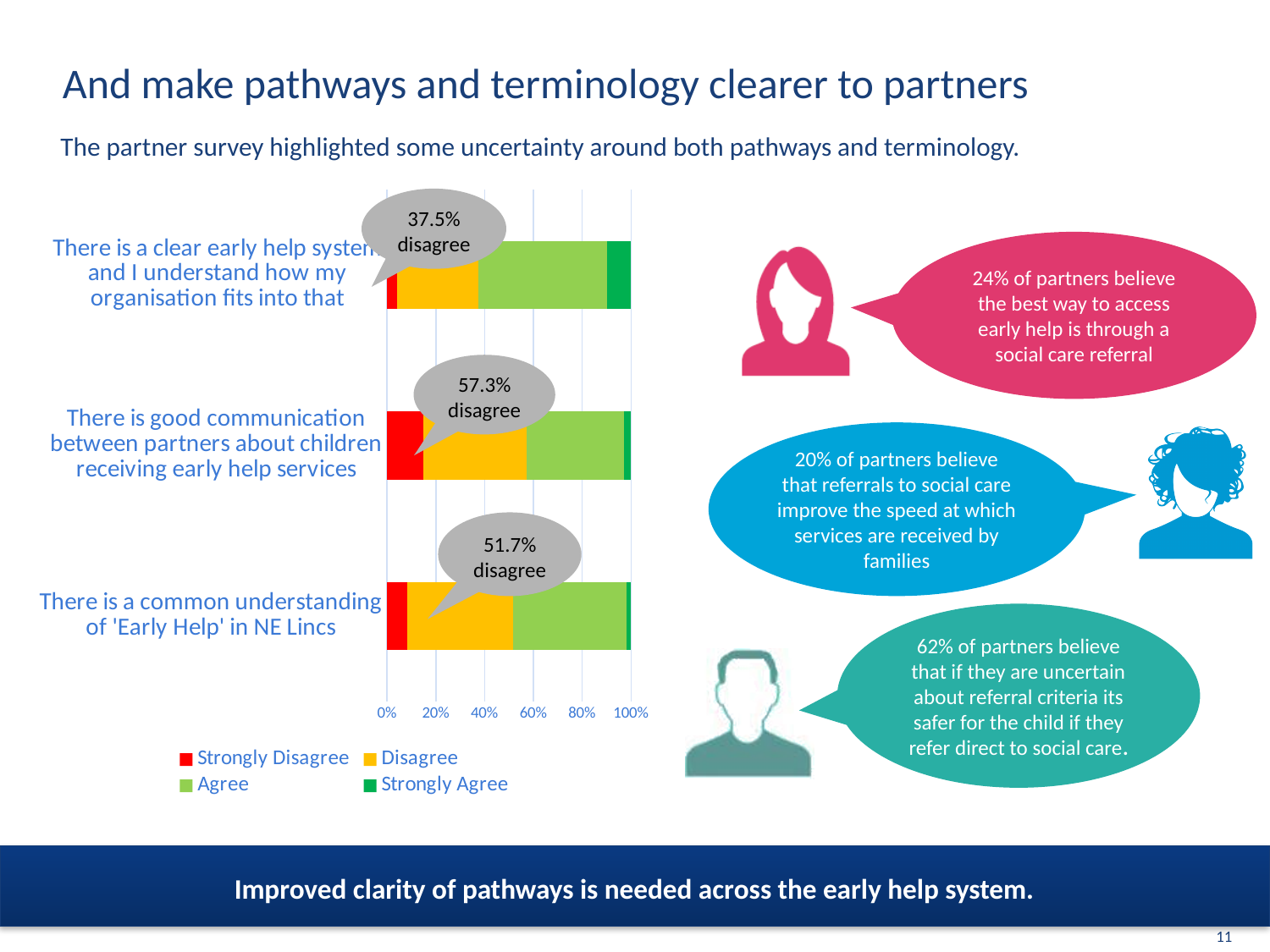
What is the difference in percentage points between the disagree share for 'good communication between partners' and the disagree share for 'a clear early help system'? 19.8 percentage points What kind of chart is shown on the slide? Stacked bar chart Which statement has the highest percentage of partners disagreeing? There is good communication between partners about children receiving early help services How many series does the chart legend list? 4 What percentage of partners disagree that there is good communication between partners about children receiving early help services? 57.3% How many statements (categories) are plotted in the chart? 3 Which has a larger disagree share: 'There is good communication between partners about children receiving early help services' or 'There is a common understanding of 'Early Help' in NE Lincs'? There is good communication between partners about children receiving early help services Is the Strongly Disagree share for 'There is good communication between partners about children receiving early help services' greater or less than 20%? less Which colour represents 'Strongly Disagree' in the chart legend? Red What percentage of partners disagree that there is a clear early help system and they understand how their organisation fits into that? 37.5% Which statement has the lowest percentage of partners disagreeing? There is a clear early help system and I understand how my organisation fits into that What percentage of partners disagree that there is a common understanding of 'Early Help' in NE Lincs? 51.7%